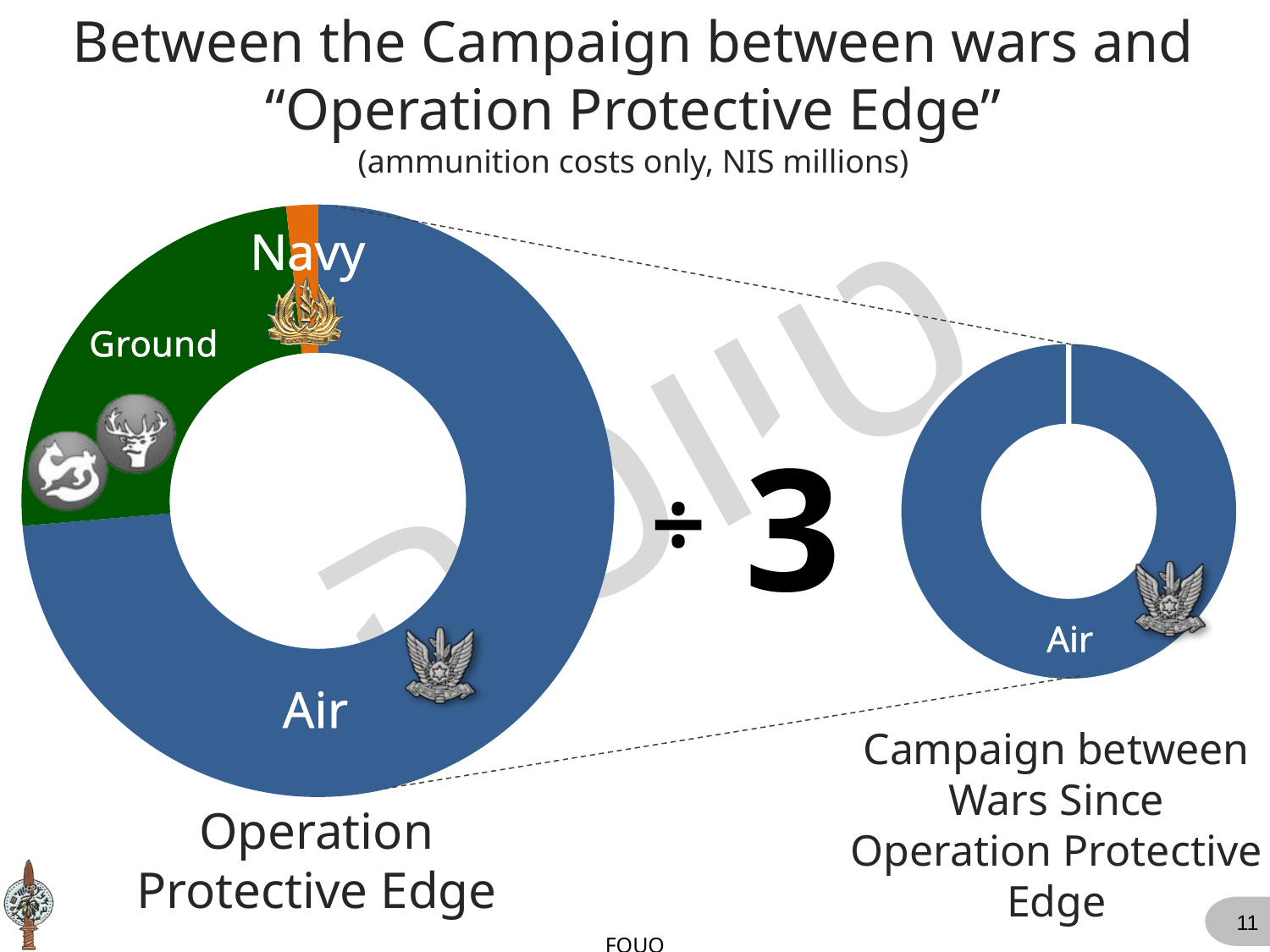
In the "Operation Protective Edge" chart, which is larger, Ground or Navy? Ground In the "Operation Protective Edge" chart, which category has the smallest share? Navy What unit are the costs in the charts measured in, according to the subtitle? NIS millions Which category is shown in the "Campaign between Wars Since Operation Protective Edge" chart on the right? Air In the "Operation Protective Edge" chart, which is larger, Air or Ground? Air In the "Operation Protective Edge" chart, which category has the largest share? Air What kind of chart is the "Operation Protective Edge" chart on the left? Donut (pie) chart How many categories are shown in the "Campaign between Wars Since Operation Protective Edge" chart on the right? 1 How many categories are shown in the "Operation Protective Edge" chart? 3 What colour is the Ground slice in the "Operation Protective Edge" chart? Green